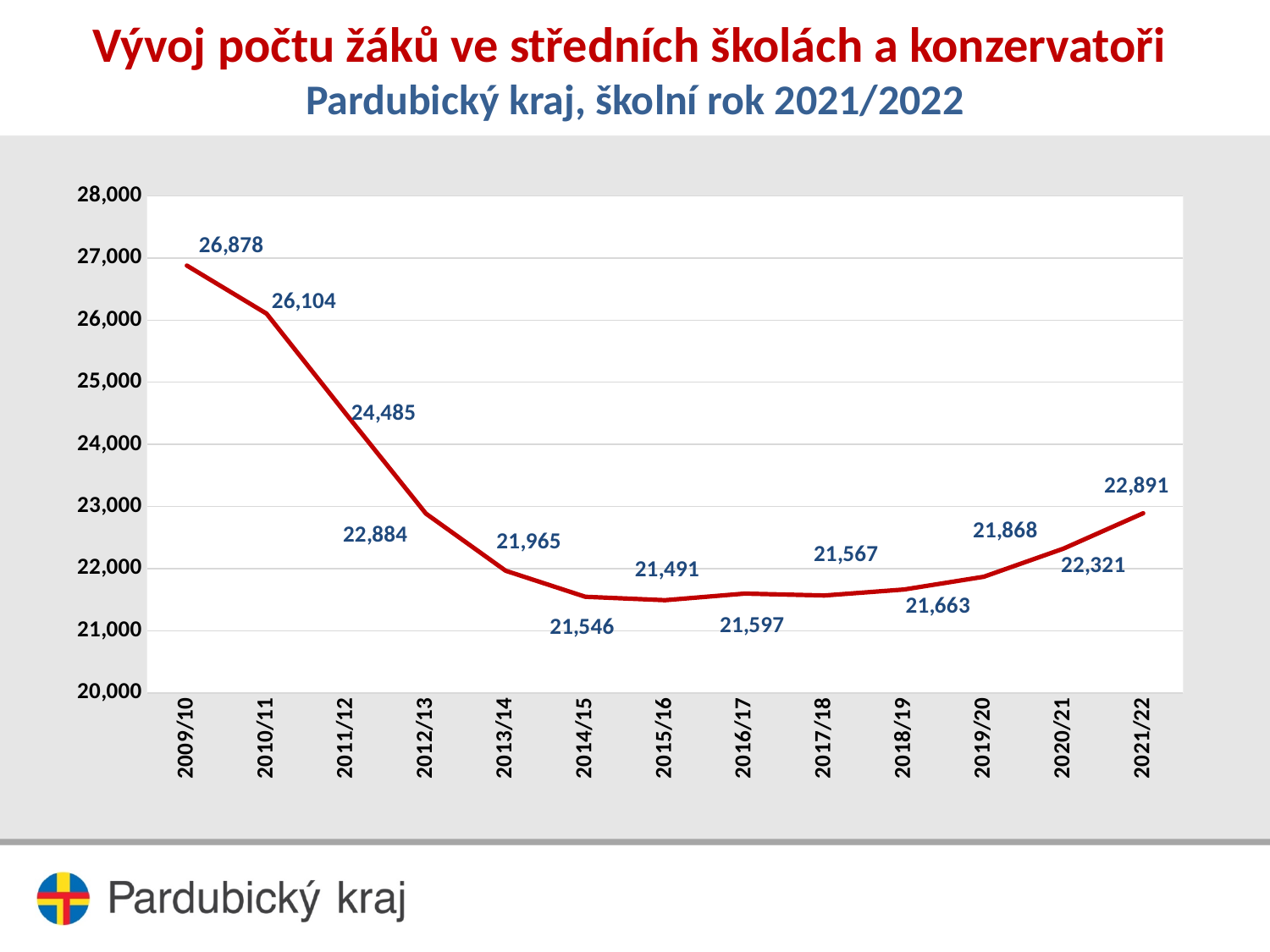
Does the number of pupils rise or fall from 2009/10 to 2015/16? fall What is the number of pupils for the school year 2021/22? 22,891 What is the number of pupils for the school year 2009/10? 26,878 How many school years are plotted on the x axis? 13 By how much did the number of pupils increase from 2020/21 to 2021/22? 570 What is the number of pupils for the school year 2012/13? 22,884 What type of chart is shown on the slide? line chart Which school year has the highest number of pupils? 2009/10 What is the number of pupils for the school year 2015/16? 21,491 Which school year has the lowest number of pupils? 2015/16 What is the difference between the number of pupils in 2009/10 and in 2021/22? 3,987 Which school year has more pupils, 2011/12 or 2019/20? 2011/12